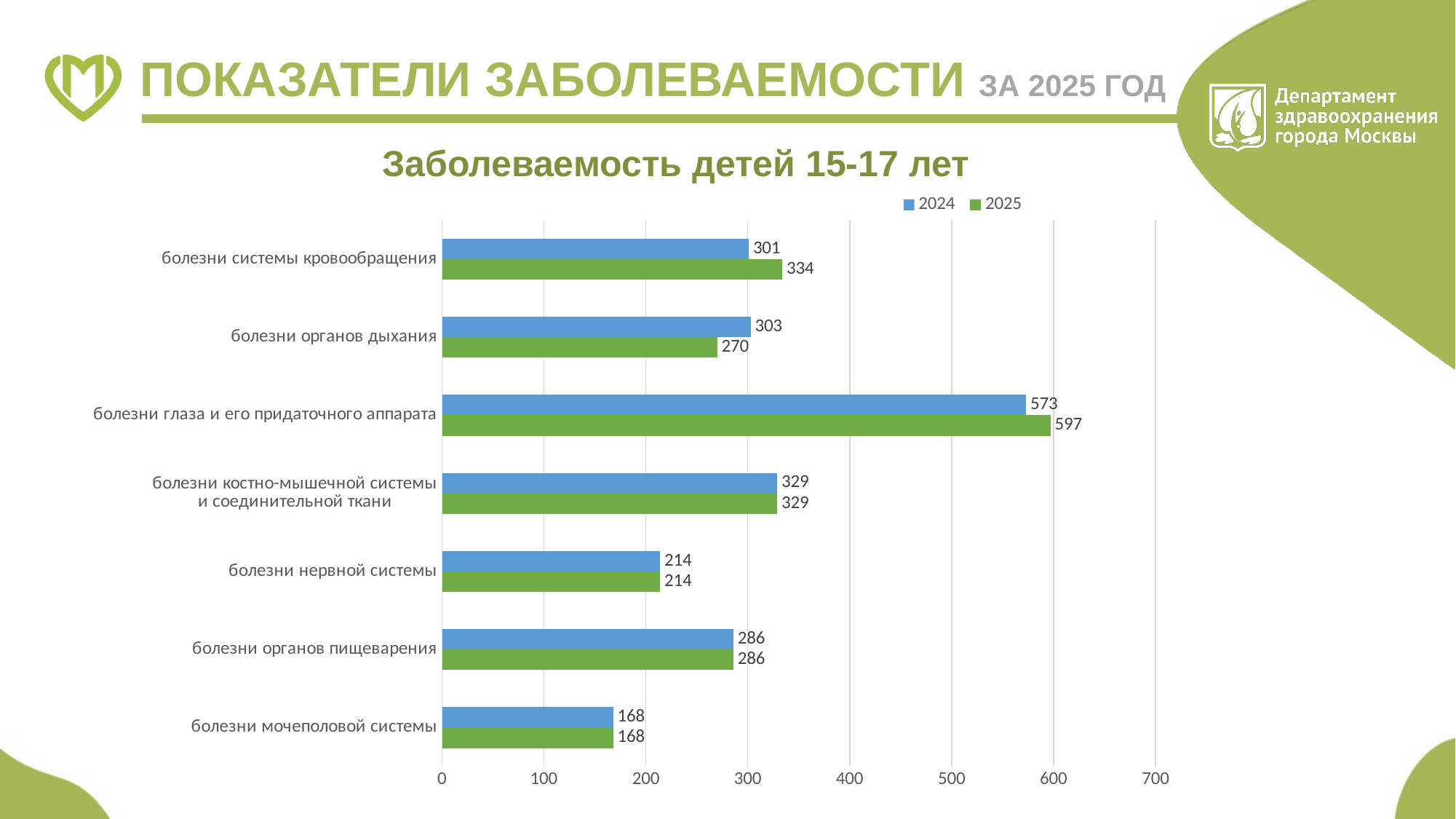
Which category has the highest 2024 value? болезни глаза и его придаточного аппарата Which category has the lowest 2025 value? болезни мочеполовой системы How many series does the legend list? 2 What is the 2025 value for болезни глаза и его придаточного аппарата? 597 How many disease categories are shown on the chart? 7 What is the difference between the 2025 and 2024 values for болезни системы кровообращения? 33 What is the 2024 value for болезни органов дыхания? 303 What kind of chart is shown on the slide? bar chart What is the difference between the 2024 and 2025 values for болезни органов дыхания? 33 What is the title of the chart? Заболеваемость детей 15-17 лет Which is larger for болезни глаза и его придаточного аппарата: the 2024 value or the 2025 value? 2025 What is the 2025 value for болезни системы кровообращения? 334